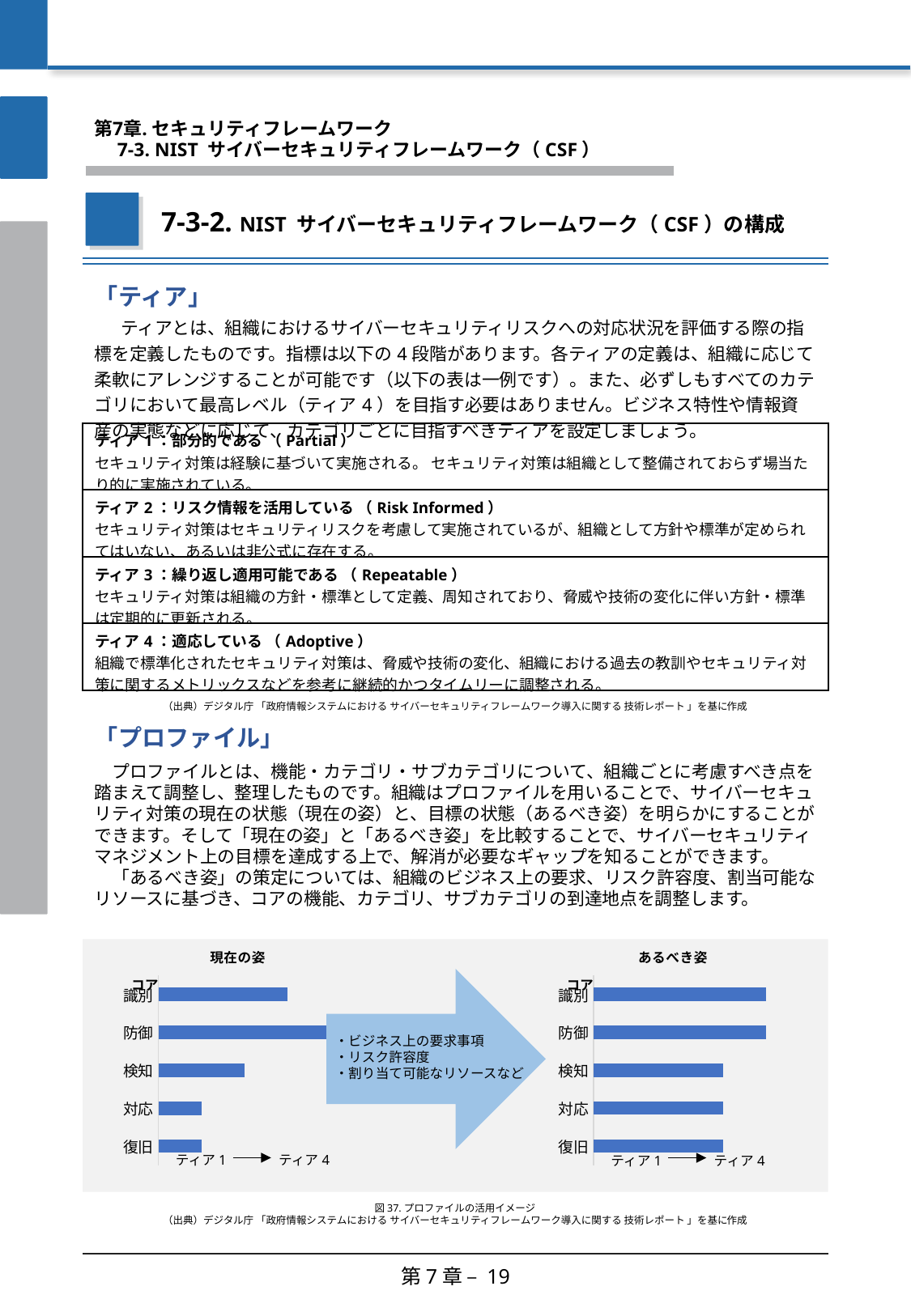
In the 現在の姿 chart on the left, which is larger, the bar for 識別 or the bar for 検知? 識別 What kind of chart is the 現在の姿 chart on the left? Bar chart What kind of chart is the あるべき姿 chart on the right? Bar chart In the あるべき姿 chart on the right, which is larger, the bar for 識別 or the bar for 復旧? 識別 In the 現在の姿 chart on the left, which is larger, the bar for 防御 or the bar for 対応? 防御 How many categories are plotted in the あるべき姿 chart on the right? 5 In the 現在の姿 chart on the left, which category has the longest bar? 防御 How many categories are plotted in the 現在の姿 chart on the left? 5 Which category is listed first (at the top) in the 現在の姿 chart on the left? 識別 What is the title of the bar chart on the right side of the figure? あるべき姿